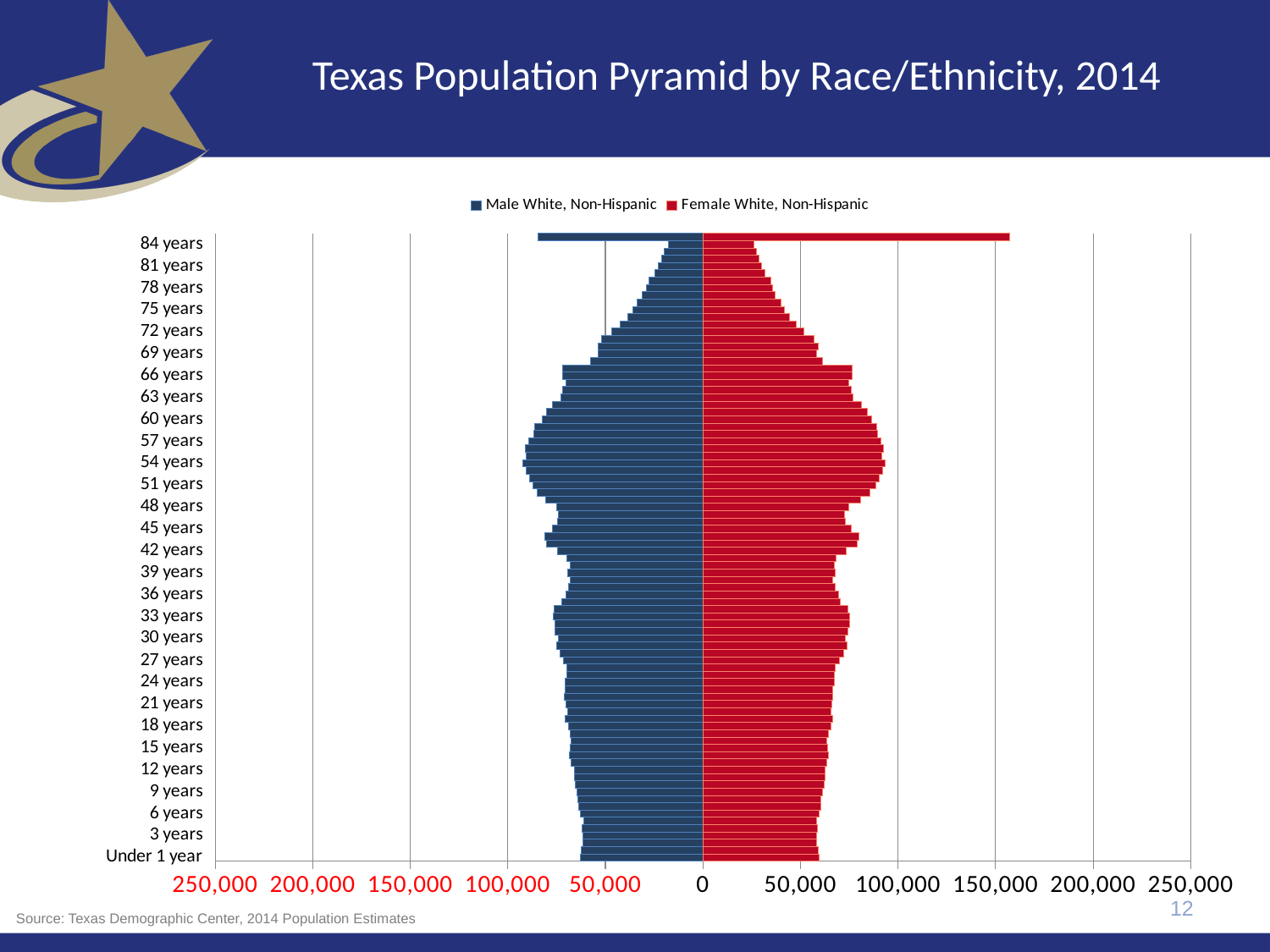
Which series is shown in red? Female White, Non-Hispanic Which is larger in magnitude for Male White, Non-Hispanic: the value at 54 years or the value at 6 years? 54 years How many series does the legend list? 2 What kind of chart is shown on the slide? Bar chart Is the value for Male White, Non-Hispanic at 78 years greater or less than 50,000 in magnitude? less Which is larger for Female White, Non-Hispanic: the value at 66 years or the value at 12 years? 66 years Is the value for Female White, Non-Hispanic at 78 years greater or less than 50,000? less Is the value for Female White, Non-Hispanic at 54 years greater or less than 50,000? greater Which is larger for Female White, Non-Hispanic: the value at 54 years or the value at 78 years? 54 years What is the title of the chart on the slide? Texas Population Pyramid by Race/Ethnicity, 2014